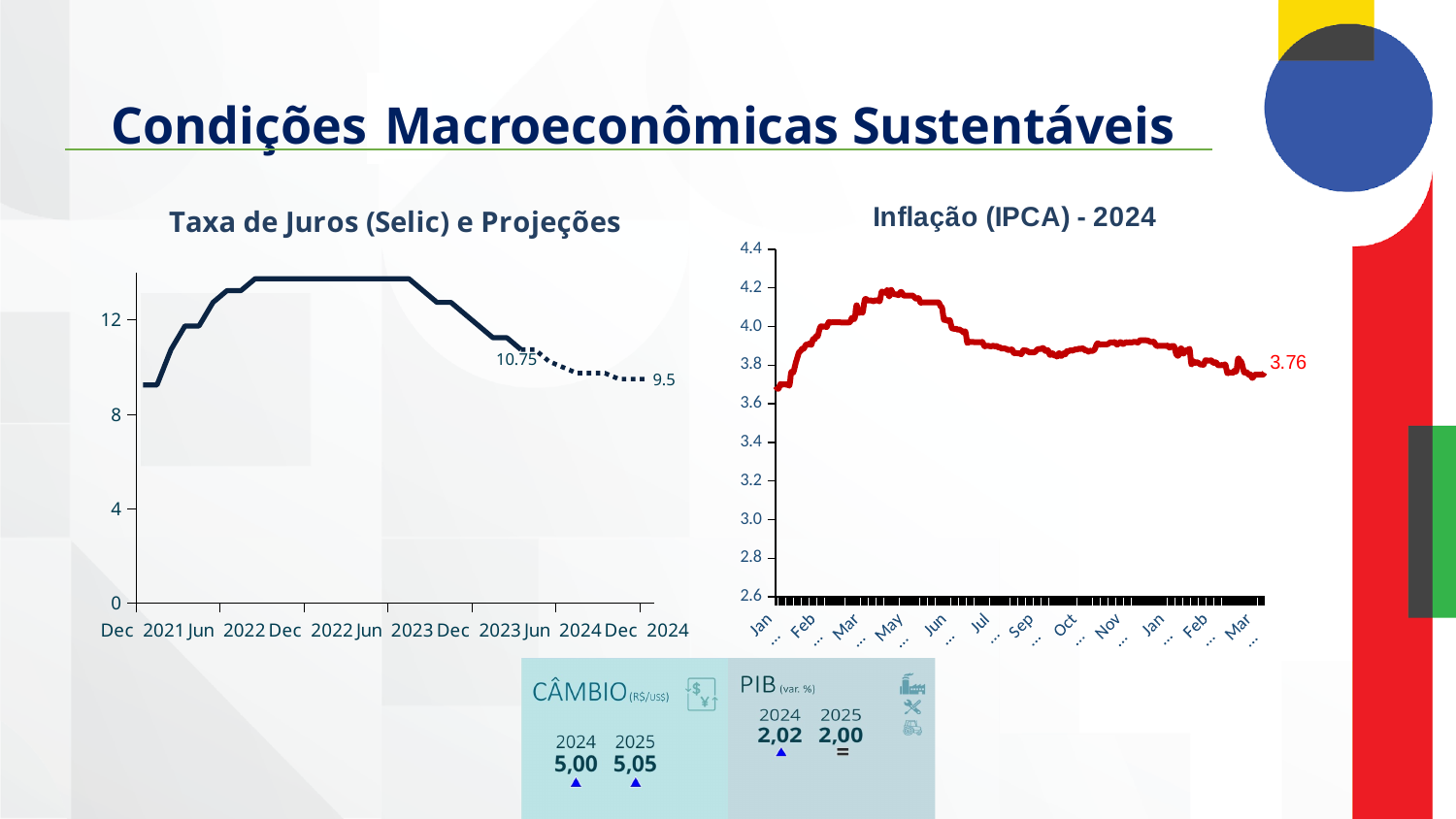
On the 'Taxa de Juros (Selic) e Projeções' chart, does the line rise or fall between Dec 2021 and Jun 2022? rise What kind of chart is 'Taxa de Juros (Selic) e Projeções'? line chart On the 'Inflação (IPCA) - 2024' chart, is the highest value of the line greater or less than 4.0? greater On the 'Taxa de Juros (Selic) e Projeções' chart, what value is labelled at the end of the dotted projection line? 9.5 On the 'Inflação (IPCA) - 2024' chart, what value is labelled at the end of the line? 3.76 On the 'Taxa de Juros (Selic) e Projeções' chart, is the highest value of the line greater or less than 12? greater On the 'Inflação (IPCA) - 2024' chart, does the line rise or fall between May and Jul? fall On the 'Taxa de Juros (Selic) e Projeções' chart, what is the difference between the labelled values 10.75 and 9.5? 1.25 On the 'Inflação (IPCA) - 2024' chart, which is larger: the value at the start in Jan or the value in May? May On the 'Taxa de Juros (Selic) e Projeções' chart, what value is labelled where the solid line ends and the dotted projection begins? 10.75 What kind of chart is 'Inflação (IPCA) - 2024'? line chart On the 'Taxa de Juros (Selic) e Projeções' chart, is the value at Dec 2021 greater or less than 12? less